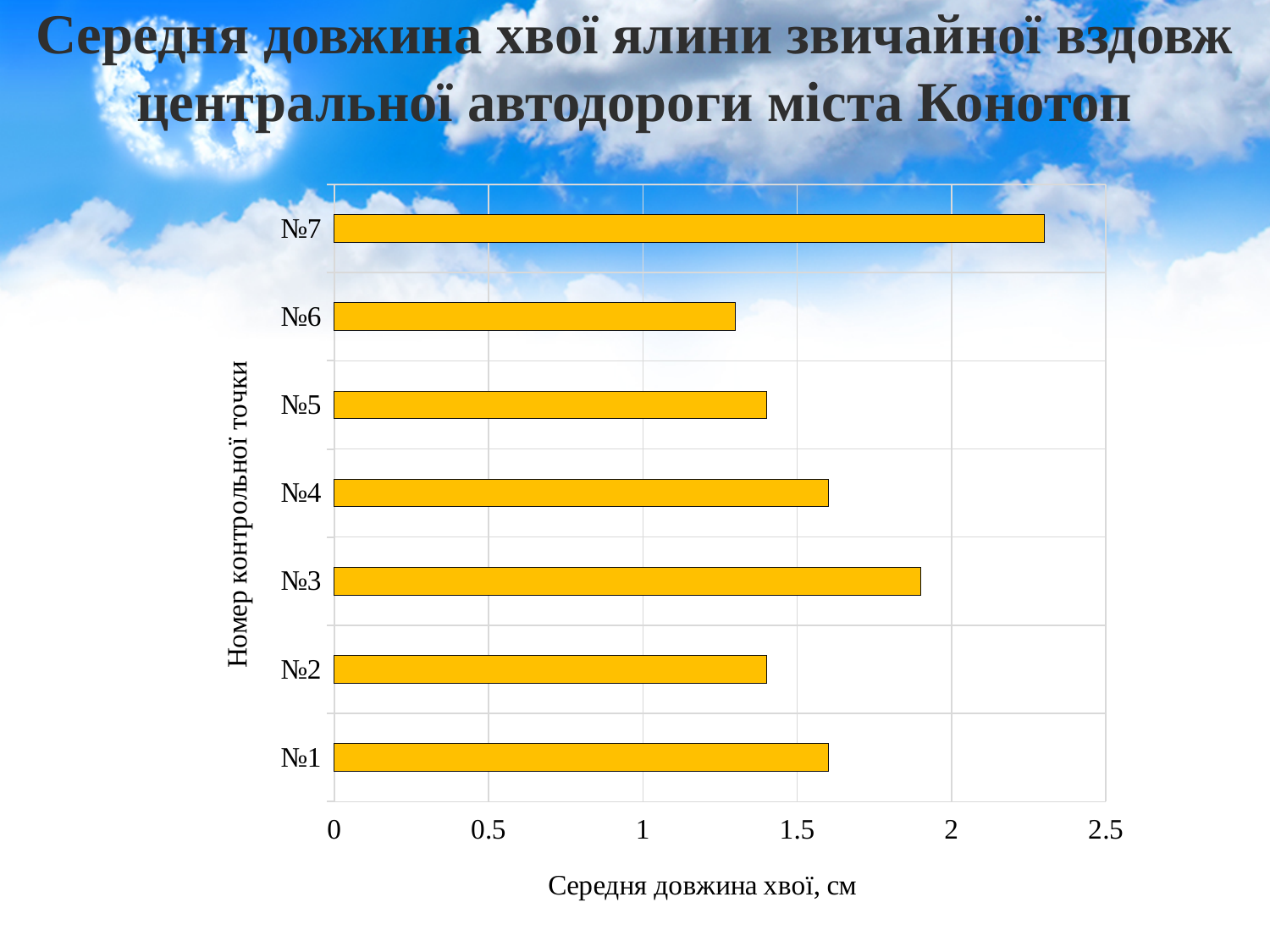
How many control points (categories) are plotted on the chart? 7 What kind of chart is shown on the slide? Bar chart Is the value for №7 greater or less than 2? greater Is the value for №3 greater or less than 1.5? greater Which has a larger value, №6 or №1? №1 Is the value for №6 greater or less than 1.5? less Which has a larger value, №3 or №4? №3 Which control point has the highest average needle length? №7 What is the title of the horizontal axis? Середня довжина хвої, см